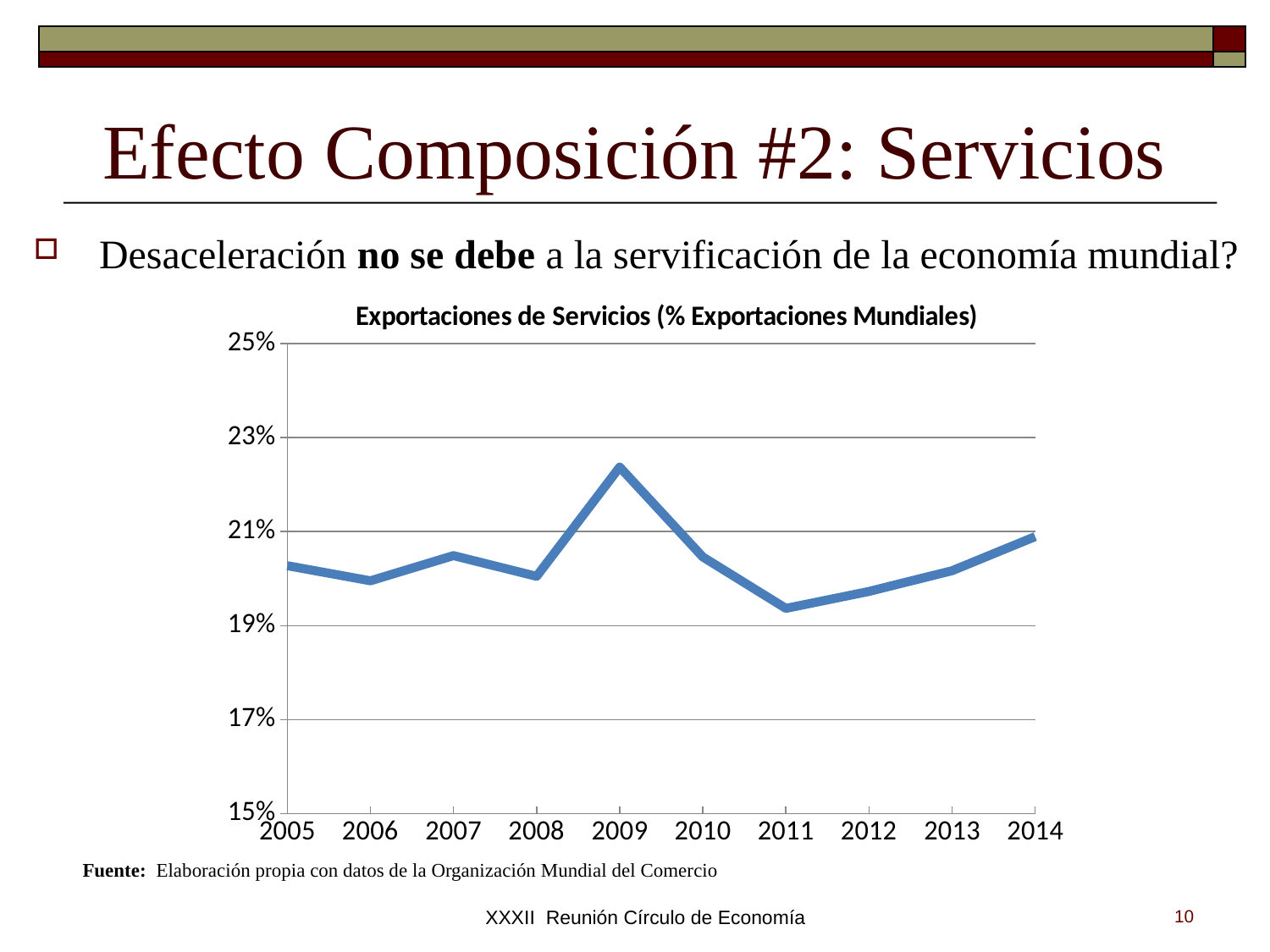
What kind of chart is shown on the slide? line chart Is the value for 2011 greater or less than 19%? greater In which year is the share of services exports highest? 2009 Is the value for 2005 greater or less than 21%? less Which year has a larger value, 2009 or 2011? 2009 How many years are plotted on the x axis of the chart? 10 Is the value for 2009 greater or less than 23%? less Do the values rise or fall from 2011 to 2014? rise Which year has a larger value, 2009 or 2005? 2009 What is the title of the chart? Exportaciones de Servicios (% Exportaciones Mundiales) In which year is the share of services exports lowest? 2011